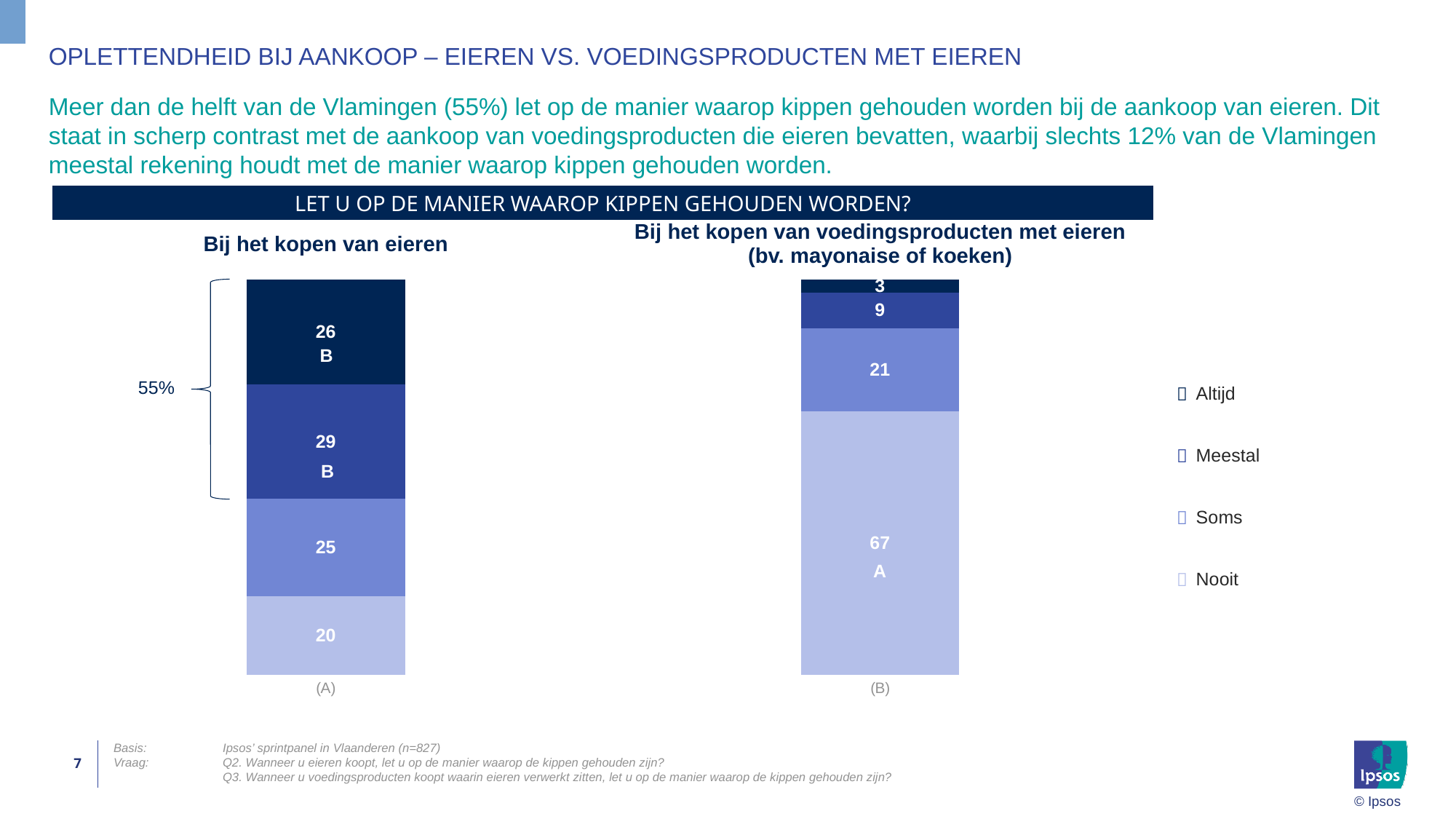
What type of chart is shown on the slide? Stacked bar chart What is the value for "Nooit" in the "Bij het kopen van voedingsproducten met eieren" bar? 67 Which bar has the larger value for "Altijd": "Bij het kopen van eieren" or "Bij het kopen van voedingsproducten met eieren"? Bij het kopen van eieren What is the value for "Soms" in the "Bij het kopen van eieren" bar? 25 Which response category has the largest value in the "Bij het kopen van voedingsproducten met eieren" bar? Nooit How many response categories does the legend list? 4 What is the value for "Altijd" in the "Bij het kopen van eieren" bar? 26 What is the combined value of "Altijd" and "Meestal" in the "Bij het kopen van eieren" bar, as shown by the bracket? 55% What is the value for "Meestal" in the "Bij het kopen van voedingsproducten met eieren" bar? 9 What is the difference between the "Nooit" values of the two bars? 47 How many stacked bars are shown in the chart? 2 Which response category has the smallest value in the "Bij het kopen van eieren" bar? Nooit